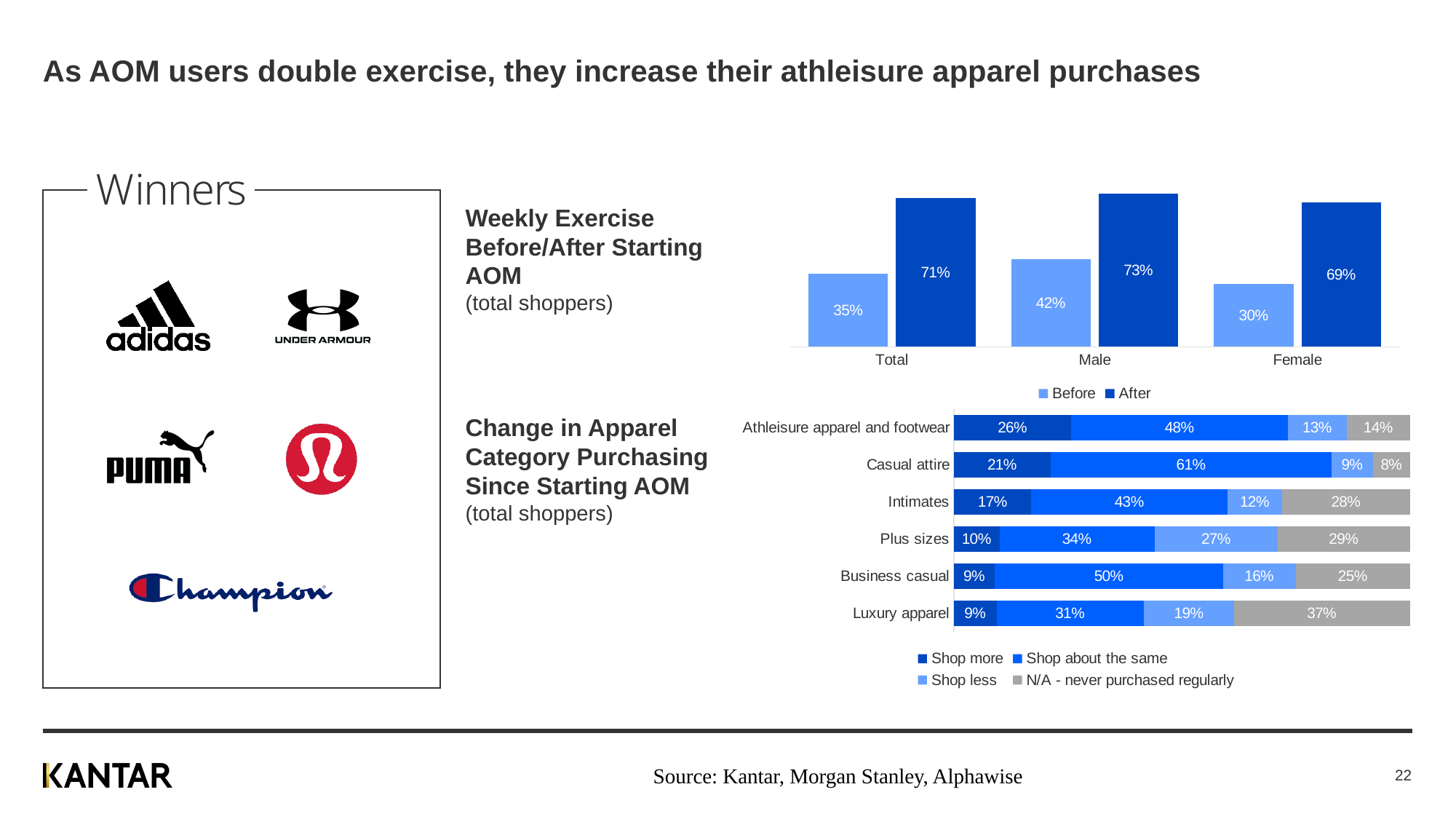
In the 'Weekly Exercise Before/After Starting AOM' chart, how many series does the legend list? 2 In the 'Change in Apparel Category Purchasing Since Starting AOM' chart, which category has the highest 'Shop more' value? Athleisure apparel and footwear In the 'Weekly Exercise Before/After Starting AOM' chart, what is the difference between the After and Before values for Total? 36% What type of chart is the 'Change in Apparel Category Purchasing Since Starting AOM' chart? Stacked bar chart In the 'Change in Apparel Category Purchasing Since Starting AOM' chart, what is the 'Shop more' value for Casual attire? 21% In the 'Weekly Exercise Before/After Starting AOM' chart, which category has the highest After value? Male In the 'Change in Apparel Category Purchasing Since Starting AOM' chart, what is the 'N/A - never purchased regularly' value for Luxury apparel? 37% In the 'Change in Apparel Category Purchasing Since Starting AOM' chart, how many apparel categories are shown? 6 In the 'Weekly Exercise Before/After Starting AOM' chart, what is the After value for Female? 69% In the 'Change in Apparel Category Purchasing Since Starting AOM' chart, which category has the lowest 'Shop about the same' value? Luxury apparel In the 'Change in Apparel Category Purchasing Since Starting AOM' chart, is the 'Shop less' value for Plus sizes larger or smaller than that for Intimates? larger In the 'Weekly Exercise Before/After Starting AOM' chart, what is the Before value for Male? 42%